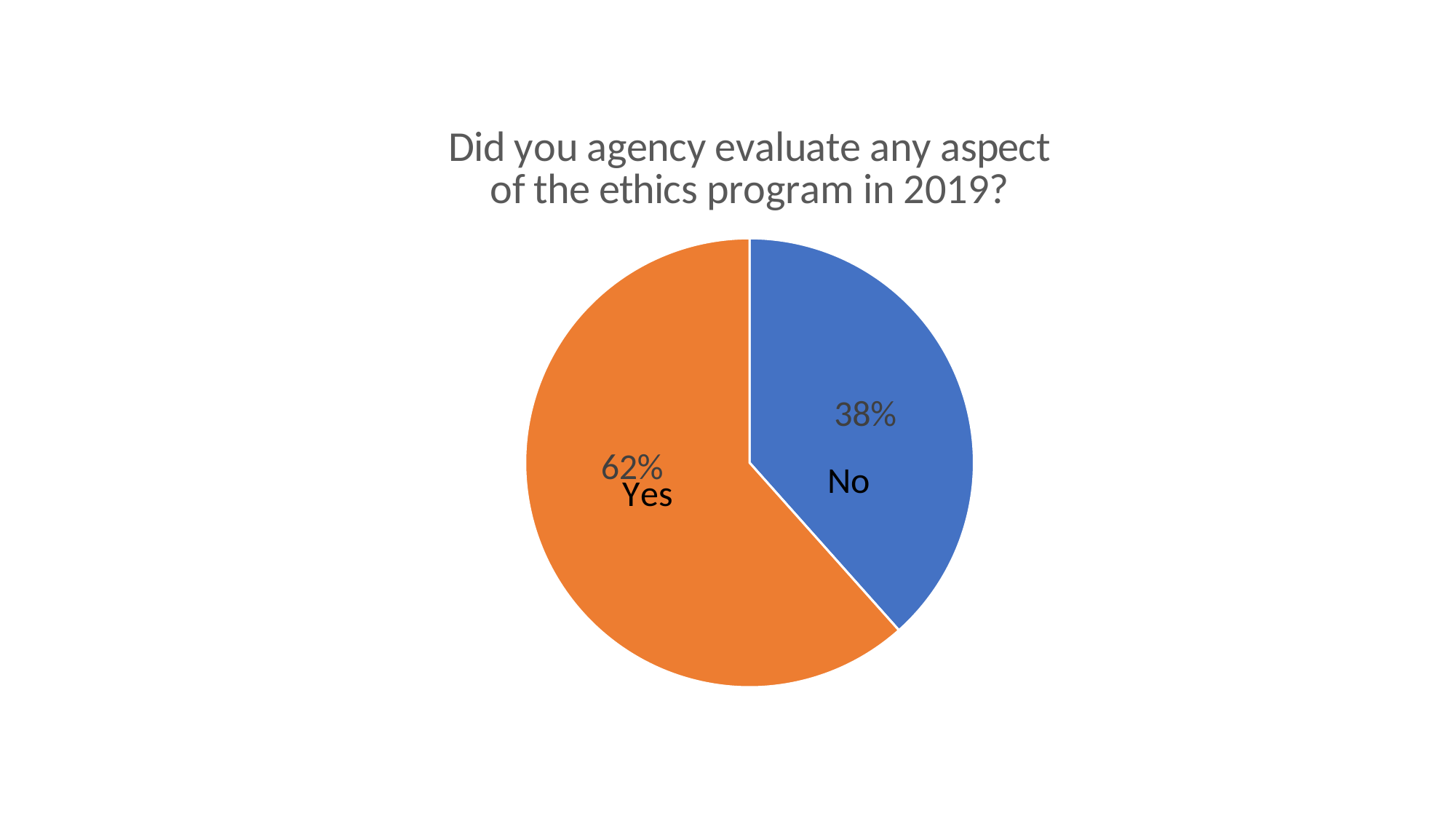
Which slice is larger, Yes or No? Yes What is the title of the chart? Did you agency evaluate any aspect of the ethics program in 2019? What share of the pie is labelled Yes? 62% What kind of chart is shown on the slide? Pie chart Which slice is the largest? Yes What colour is the Yes slice? Orange How many slices does the pie chart have? 2 Is the share for Yes greater or less than 50%? greater Is the share for No greater or less than 50%? less Which slice is the smallest? No What is the difference in percentage points between the Yes and No slices? 24 What share of the pie is labelled No? 38%